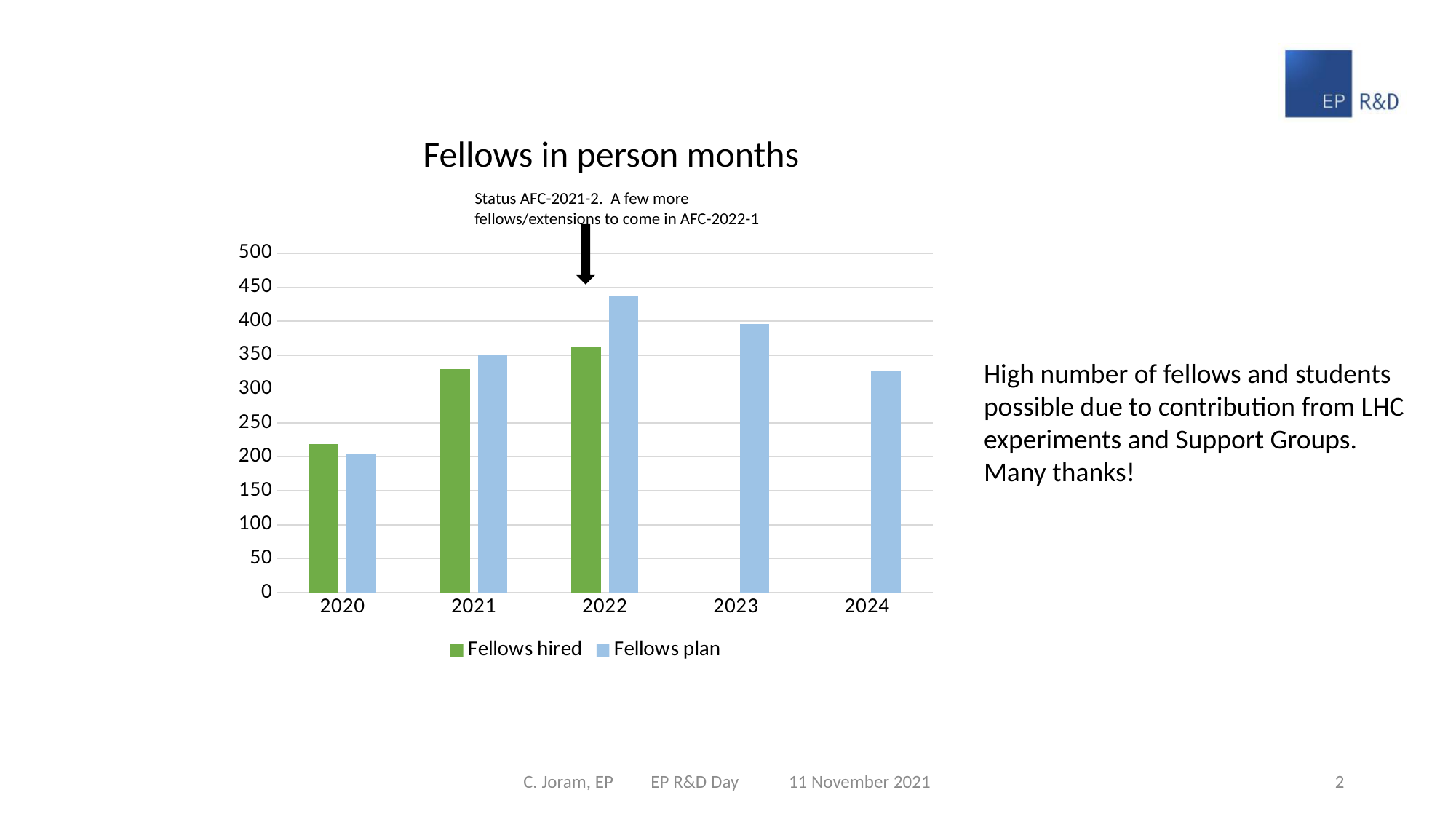
Which year has the highest Fellows plan value? 2022 In 2022, which is larger, Fellows hired or Fellows plan? Fellows plan Which year has the lowest Fellows hired value? 2020 In 2020, which is larger, Fellows hired or Fellows plan? Fellows hired How many series does the legend list? 2 Which year has the lowest Fellows plan value? 2020 Do the Fellows hired values rise or fall from 2020 to 2022? rise Is the Fellows hired value for 2020 greater or less than 250? less What kind of chart is shown on the slide? bar chart How many years are shown on the x axis? 5 Is the Fellows plan value for 2022 greater or less than 400? greater What is the title of the chart? Fellows in person months